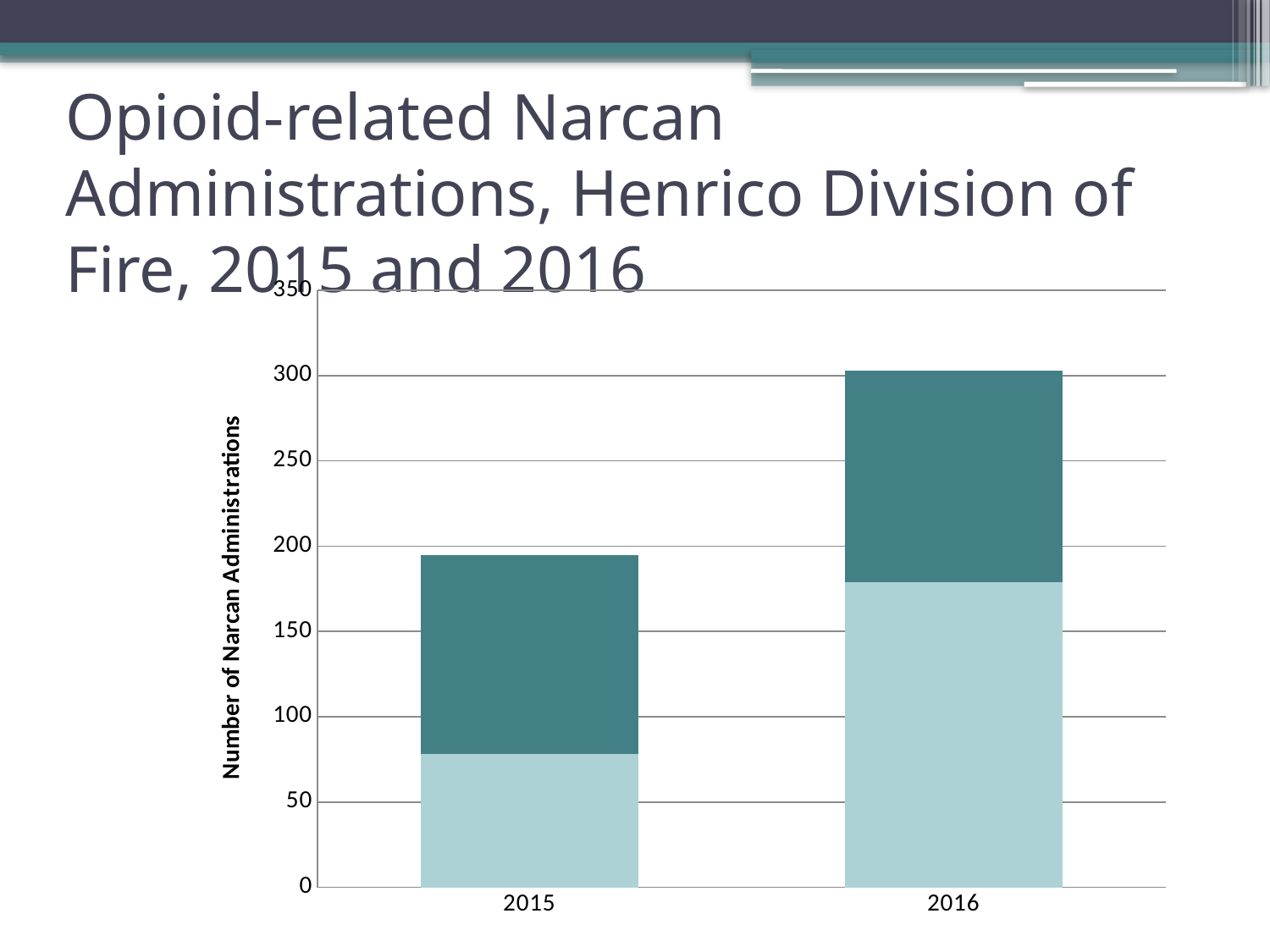
Do the total Narcan administrations rise or fall from 2015 to 2016? rise Is the light-coloured (bottom) segment of the 2016 bar greater or less than 150? greater Is the total value for 2016 greater or less than 250? greater What is the highest value shown on the vertical axis of the chart? 350 How many years (categories) are shown on the x axis of the chart? 2 Which year has the higher total number of Narcan administrations? 2016 What type of chart is shown on the slide? stacked bar chart Is the total bar for 2016 taller or shorter than the total bar for 2015? taller Is the total value for 2015 greater or less than 150? greater What is the label on the vertical axis of the chart? Number of Narcan Administrations Which year has the lower total number of Narcan administrations? 2015